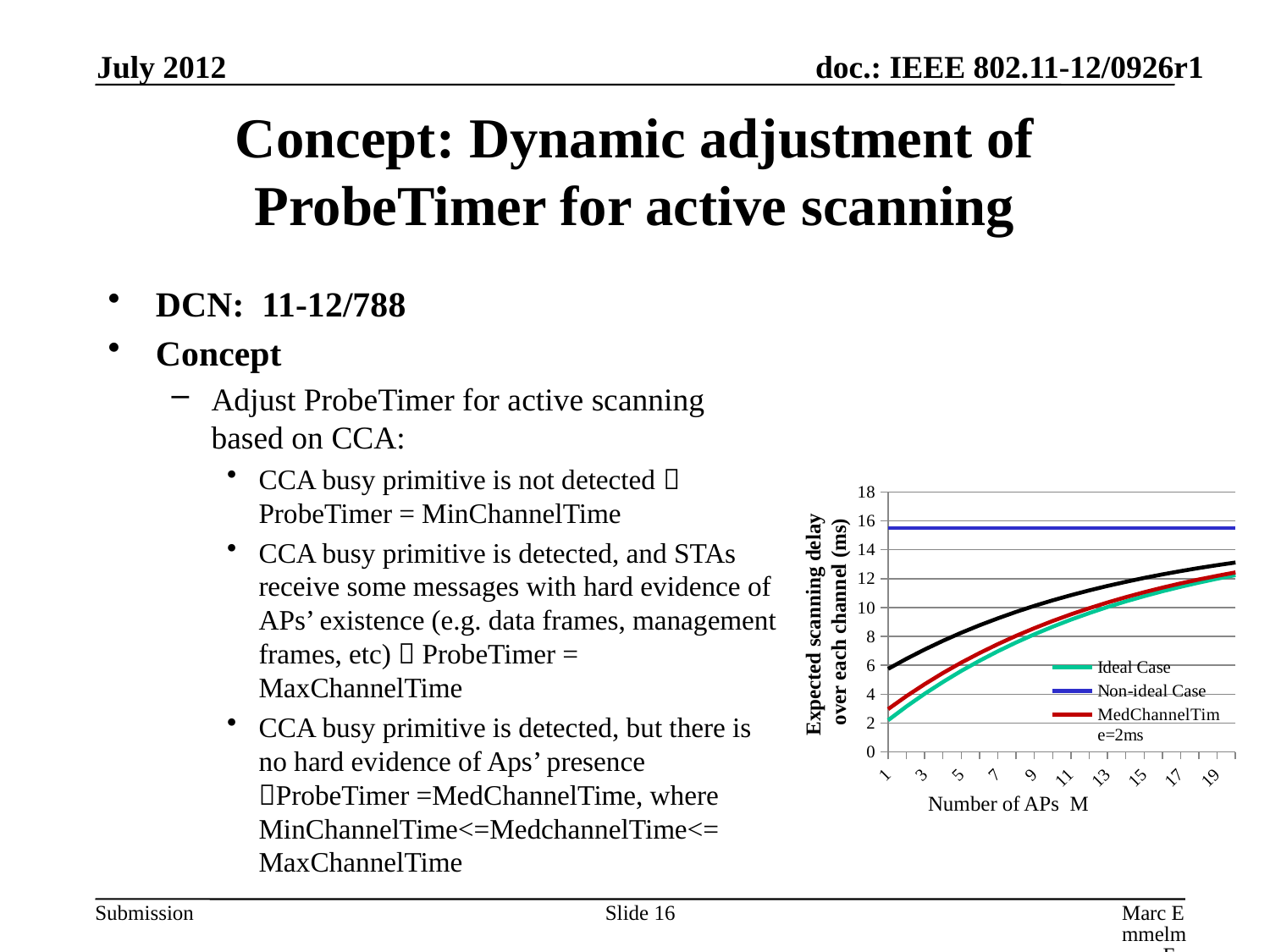
Is the value of the Ideal Case series at 19 APs greater or less than 10? greater At 1 AP, which series has the larger value: Non-ideal Case or Ideal Case? Non-ideal Case What is the title of the y axis of the chart? Expected scanning delay over each channel (ms) Is the value of the Non-ideal Case series at 1 AP greater or less than 14? greater Does the Ideal Case series rise or fall as the number of APs increases? rise Does the Non-ideal Case series rise, fall, or stay flat as the number of APs increases? stay flat What is the title of the x axis of the chart? Number of APs M What kind of chart is shown on the slide? line chart At 19 APs, which series has the larger value: Non-ideal Case or MedChannelTime=2ms? Non-ideal Case How many series does the chart's legend list? 3 Is the value of the Ideal Case series at 1 AP greater or less than 4? less